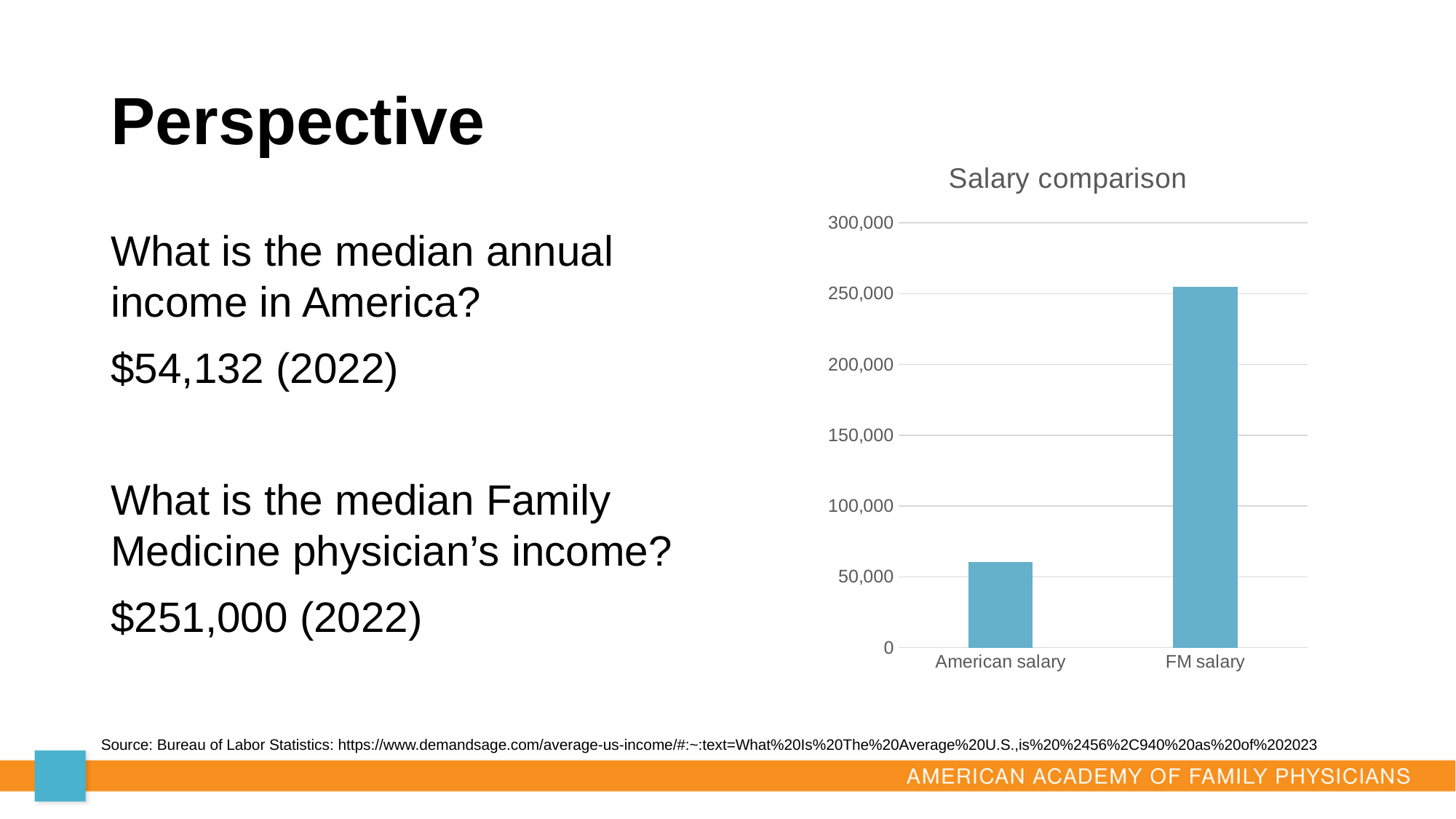
Is the value for American salary greater or less than 100,000? less Which category has the highest value in the Salary comparison chart? FM salary What is the title of the chart? Salary comparison What kind of chart is shown on the slide? bar chart Is the value for FM salary greater or less than 200,000? greater Is the value for American salary greater or less than 50,000? greater Which is larger in the Salary comparison chart, American salary or FM salary? FM salary What is the highest value shown on the vertical axis of the Salary comparison chart? 300,000 Which category has the lowest value in the Salary comparison chart? American salary How many categories are plotted in the Salary comparison chart? 2 Do the bar values rise or fall from left to right in the Salary comparison chart? rise